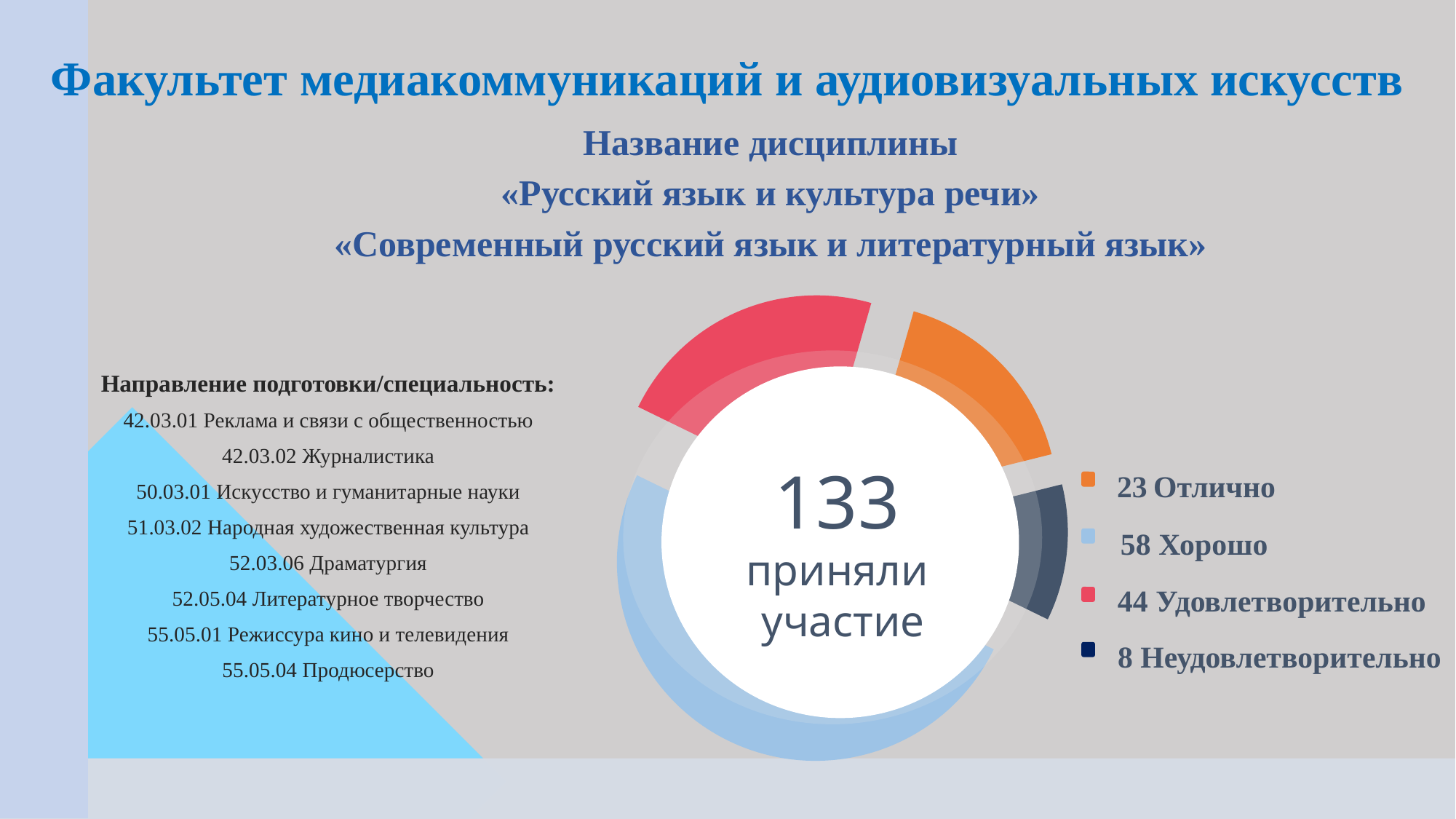
What is the value for «Неудовлетворительно»? 8 What is the value shown for «Хорошо» in the chart legend? 58 How many grade categories does the chart show? 4 What colour represents «Неудовлетворительно» in the chart? Dark navy blue What is the difference between the number of «Хорошо» and «Отлично» grades? 35 How many students received the grade «Отлично» according to the chart? 23 Which grade category has the highest value in the chart? Хорошо Which is larger: the value for «Удовлетворительно» or for «Отлично»? Удовлетворительно What type of chart is shown on the slide? Donut (pie) chart How many students received «Удовлетворительно»? 44 Which grade category has the lowest value in the chart? Неудовлетворительно What is the total number of participants shown in the centre of the chart? 133